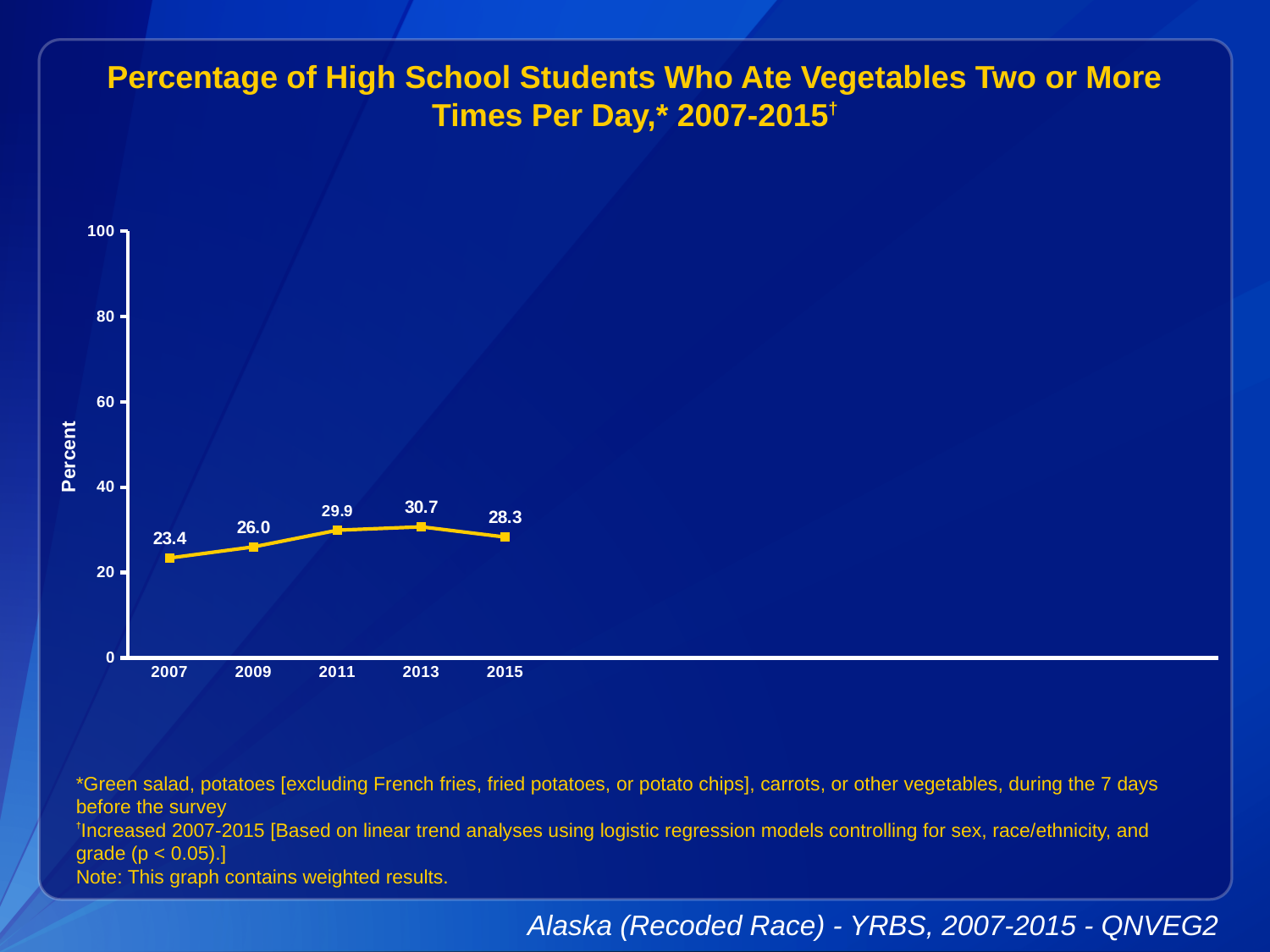
Which year has the highest value? 2013 What is the value for 2013? 30.7 What is the value for 2015? 28.3 What is the value for 2007? 23.4 Is the value for 2009 greater or less than 40? less Which year has the lowest value? 2007 Which is larger, the value for 2011 or the value for 2015? 2011 Do the values rise or fall from 2007 to 2013? rise What is the label on the y axis? Percent How many years are plotted on the chart? 5 What is the difference between the values for 2013 and 2007? 7.3 What kind of chart is shown? line chart